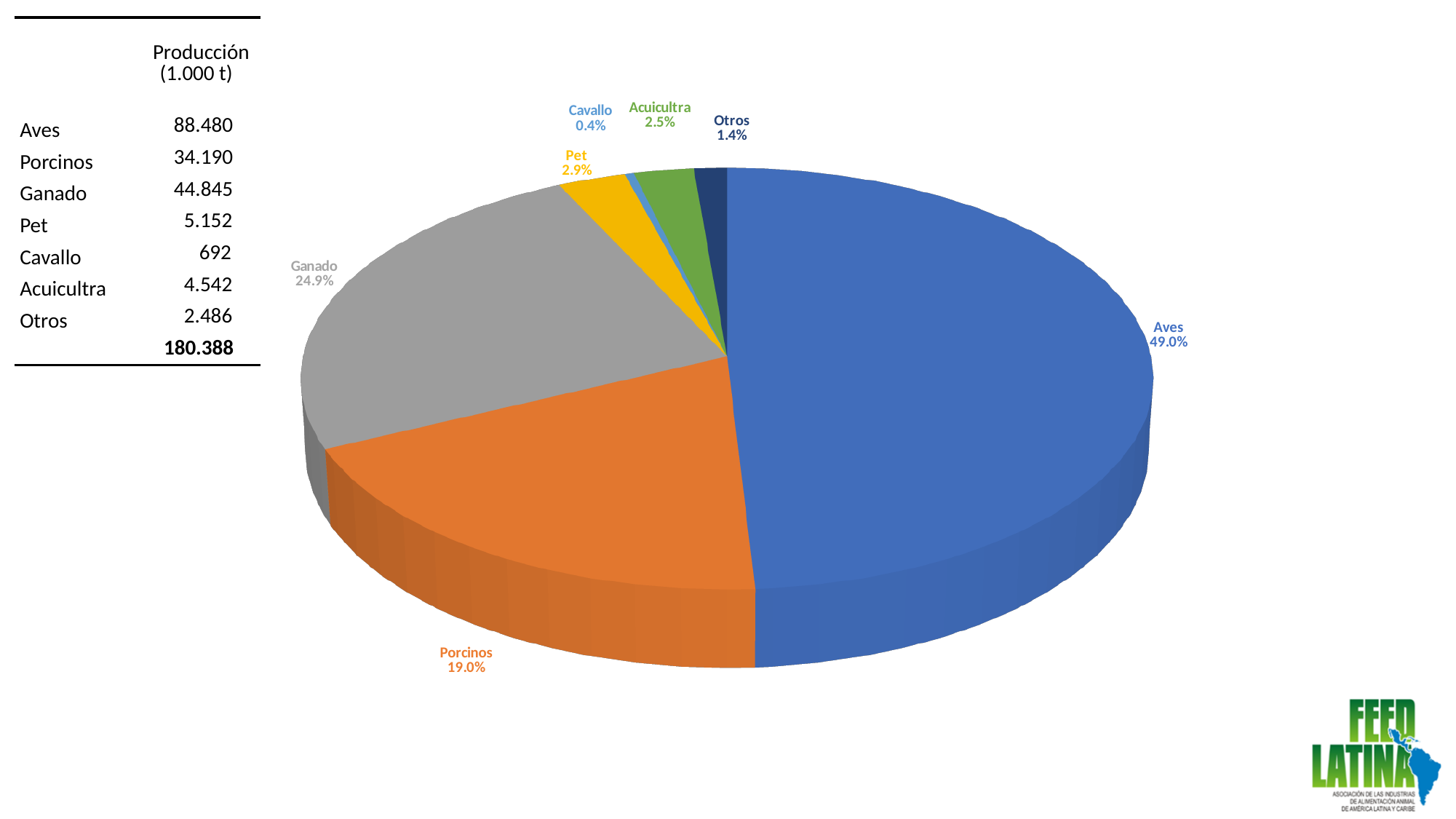
How many slices does the pie chart have? 7 Which slice is larger, Acuicultra or Otros? Acuicultra What share of the pie does Cavallo represent? 0.4% What colour is the Porcinos slice? Orange What share of the pie does Aves represent? 49.0% Which category has the largest slice of the pie? Aves What kind of chart is shown on the slide? Pie chart What share of the pie does Ganado represent? 24.9% What is the difference in percentage points between the Aves and Ganado slices? 24.1 Which category has the smallest slice of the pie? Cavallo